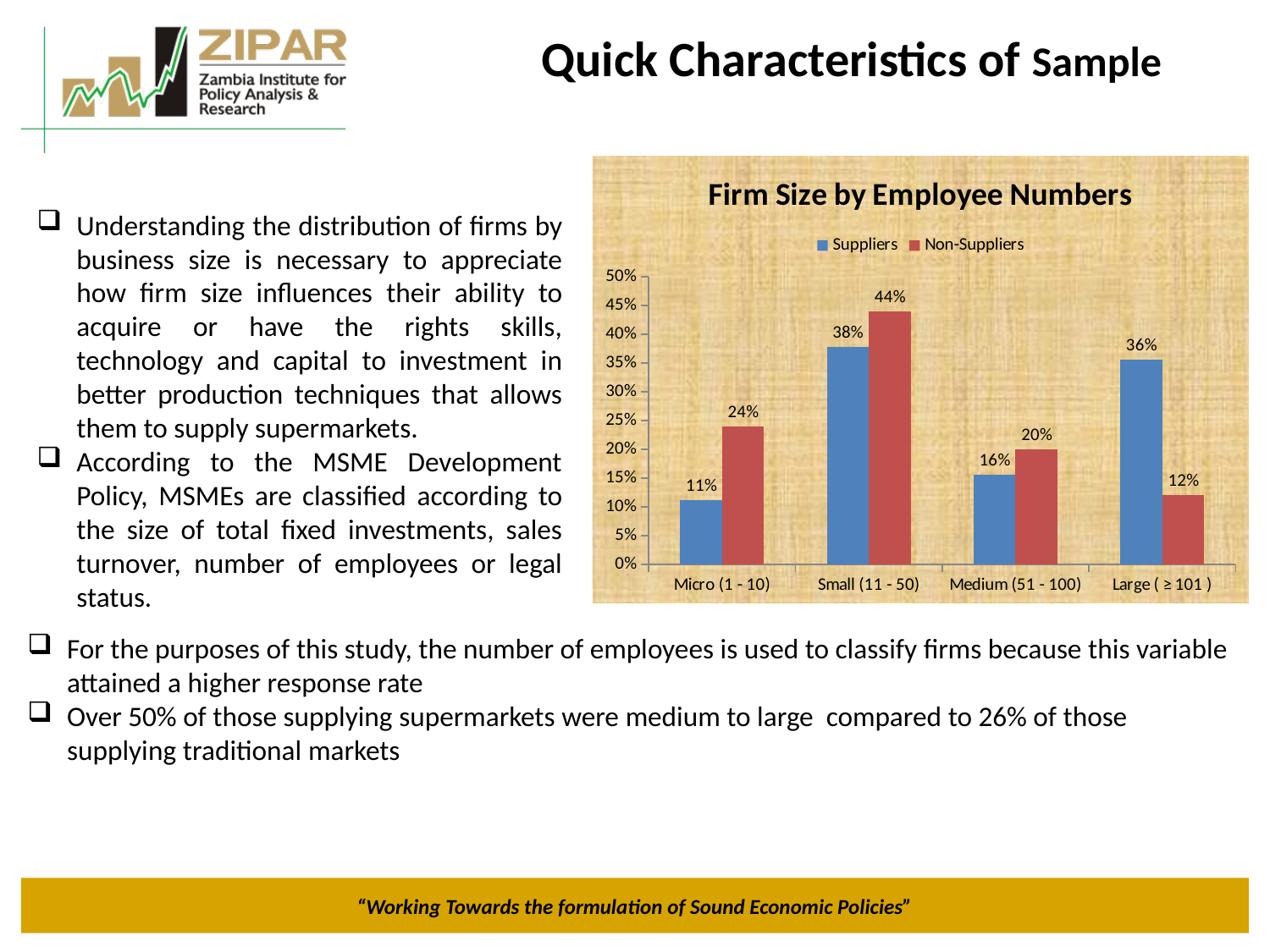
Which category has the lowest value for Suppliers? Micro (1 - 10) Which category has the highest value for Non-Suppliers? Small (11 - 50) In the Medium (51 - 100) category, which series has the larger value, Suppliers or Non-Suppliers? Non-Suppliers How many categories are shown on the x axis of the chart? 4 What is the value for Suppliers in the Large ( ≥ 101 ) category? 36% What is the difference between Suppliers and Non-Suppliers in the Large ( ≥ 101 ) category? 24% What is the value for Suppliers in the Small (11 - 50) category? 38% What is the difference between Non-Suppliers and Suppliers in the Micro (1 - 10) category? 13% What is the value for Non-Suppliers in the Micro (1 - 10) category? 24% What is the title of the chart? Firm Size by Employee Numbers What kind of chart is shown on the slide? Bar chart How many series does the chart legend list? 2